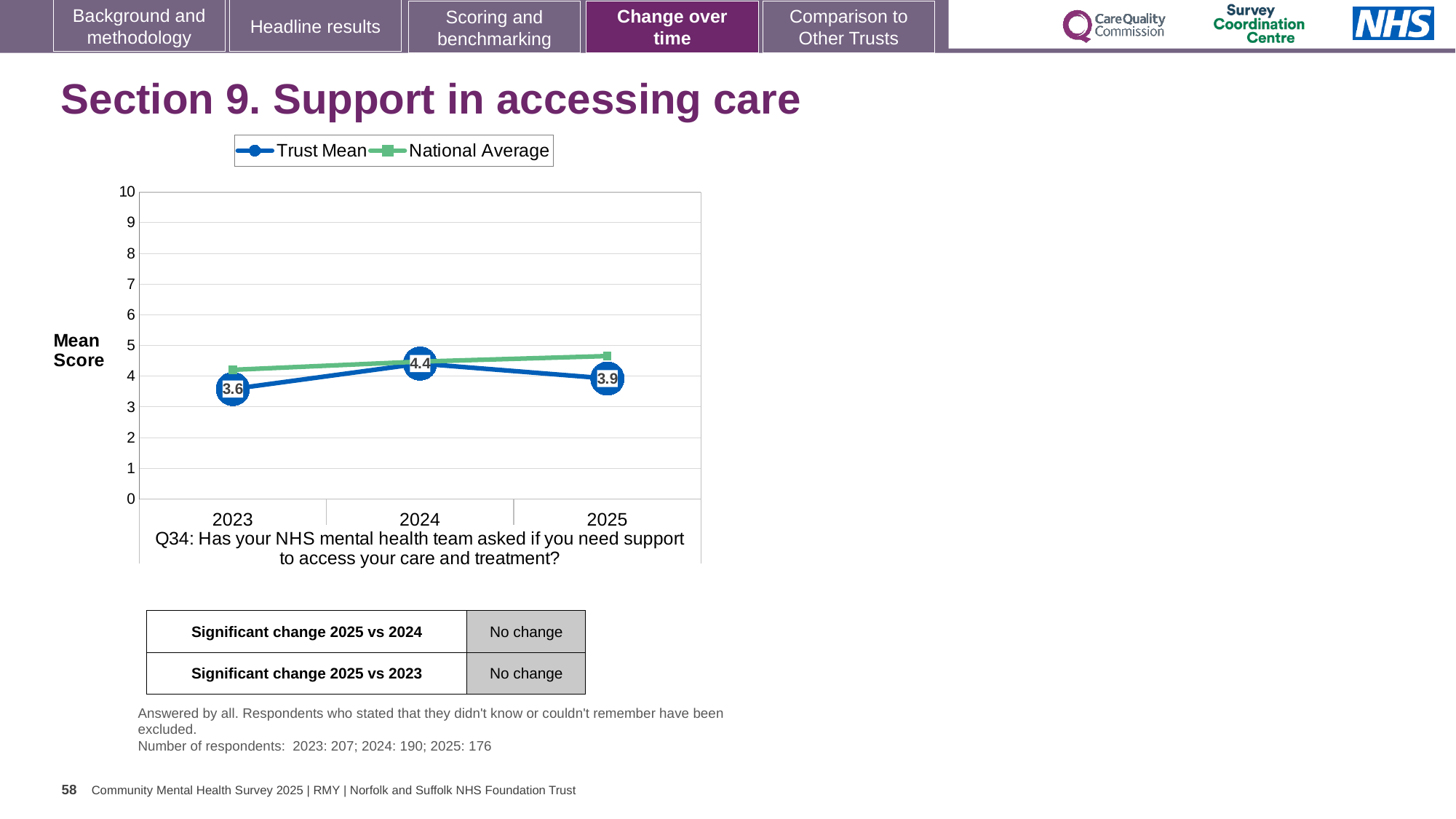
What is the Trust Mean score for 2023? 3.6 What is the difference between the Trust Mean in 2024 and in 2023? 0.8 What is the Trust Mean score for 2025? 3.9 Is the National Average value for 2025 greater or less than 5? less Does the Trust Mean rise or fall from 2024 to 2025? Fall What kind of chart is shown on the slide? Line chart In which year is the Trust Mean lowest? 2023 In which year is the Trust Mean highest? 2024 How many series does the legend list? 2 What is the Trust Mean score for 2024? 4.4 How many years are plotted on the x axis? 3 Which is larger, the Trust Mean in 2025 or in 2023? 2025